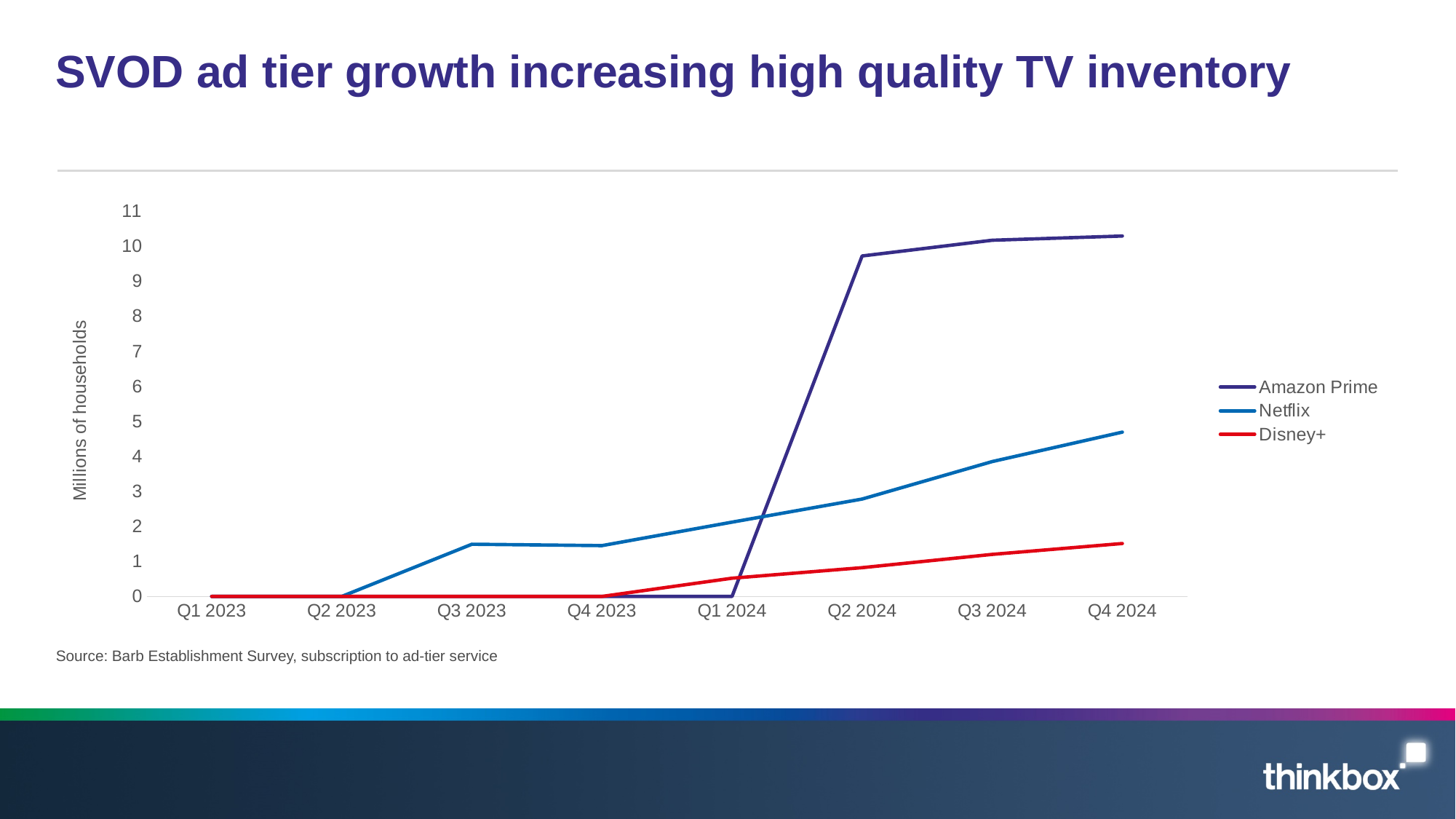
What is the value for Netflix in Q2 2023? 0 What kind of chart is shown on the slide? line chart Is the value for Amazon Prime in Q2 2024 greater or less than 9? greater How many series does the legend list? 3 Which series has the lowest value in Q4 2024? Disney+ What is the value for Disney+ in Q4 2023? 0 How many quarters are plotted along the x axis? 8 Is the value for Netflix in Q4 2024 greater or less than 4? greater Which series has the highest value in Q4 2024? Amazon Prime Which is larger in Q4 2024, Netflix or Disney+? Netflix What is the label on the y axis? Millions of households What is the value for Amazon Prime in Q1 2024? 0